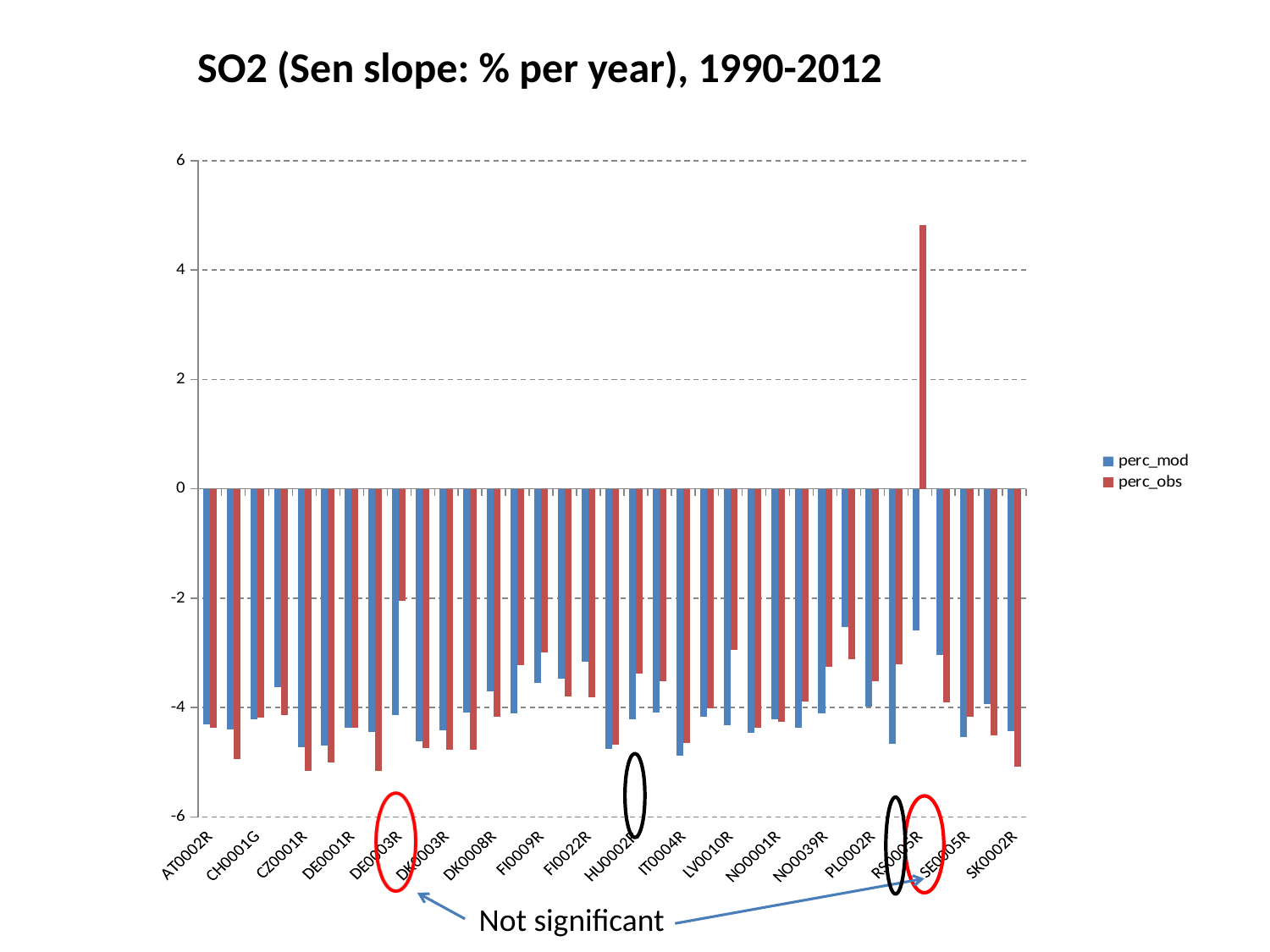
What are the two series named in the legend? perc_mod and perc_obs For DE0003R, which series has the larger value, perc_mod or perc_obs? perc_obs Is the highest value on the chart greater or less than 4? greater How many series does the legend list? 2 Is the perc_obs value for SK0002R greater or less than -4? less Is the perc_mod value for AT0002R greater or less than -2? less Which series contains the highest value on the chart? perc_obs What is the title of the chart? SO2 (Sen slope: % per year), 1990-2012 How many bars on the chart have a positive value? 1 What kind of chart is shown on the slide? bar chart What is the range of the vertical axis? -6 to 6